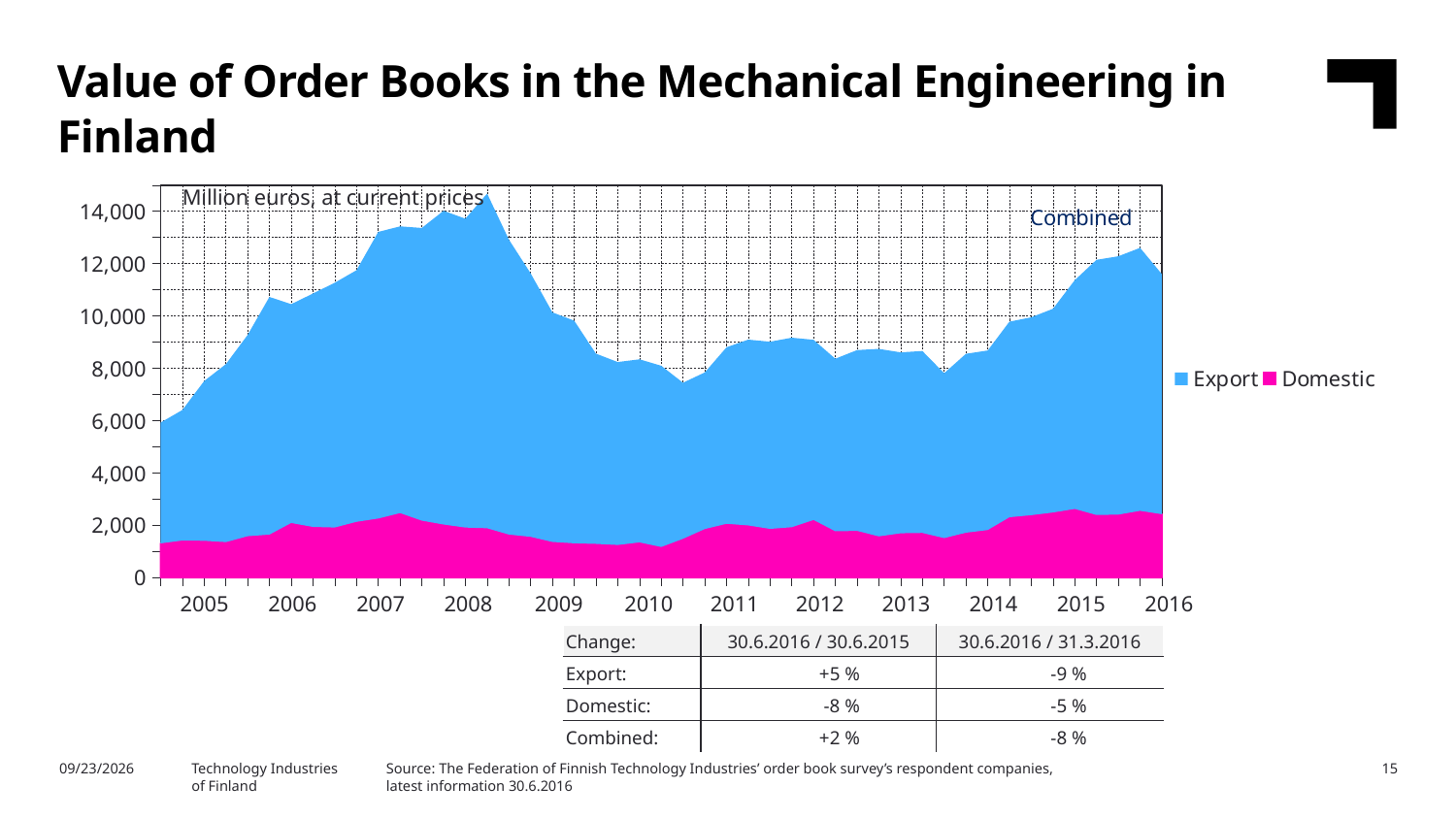
What type of chart is shown on the slide? Stacked area chart What are the two series shown in the legend? Export and Domestic In which year is the combined value of order books at its lowest? 2005 Is the Domestic value in 2010 greater or less than 2,000? less Does the combined value rise or fall between its 2008 peak and 2009? fall How many series does the legend list? 2 What unit is stated on the chart for the values? Million euros, at current prices How many years are labelled on the x axis? 12 Is the combined value at the end of the series in 2016 greater or less than 10,000? greater In which year does the combined value of order books reach its highest point? 2008 Which is larger, the combined value in 2008 or the combined value in 2012? 2008 Is the combined value at the start of 2005 greater or less than 8,000? less